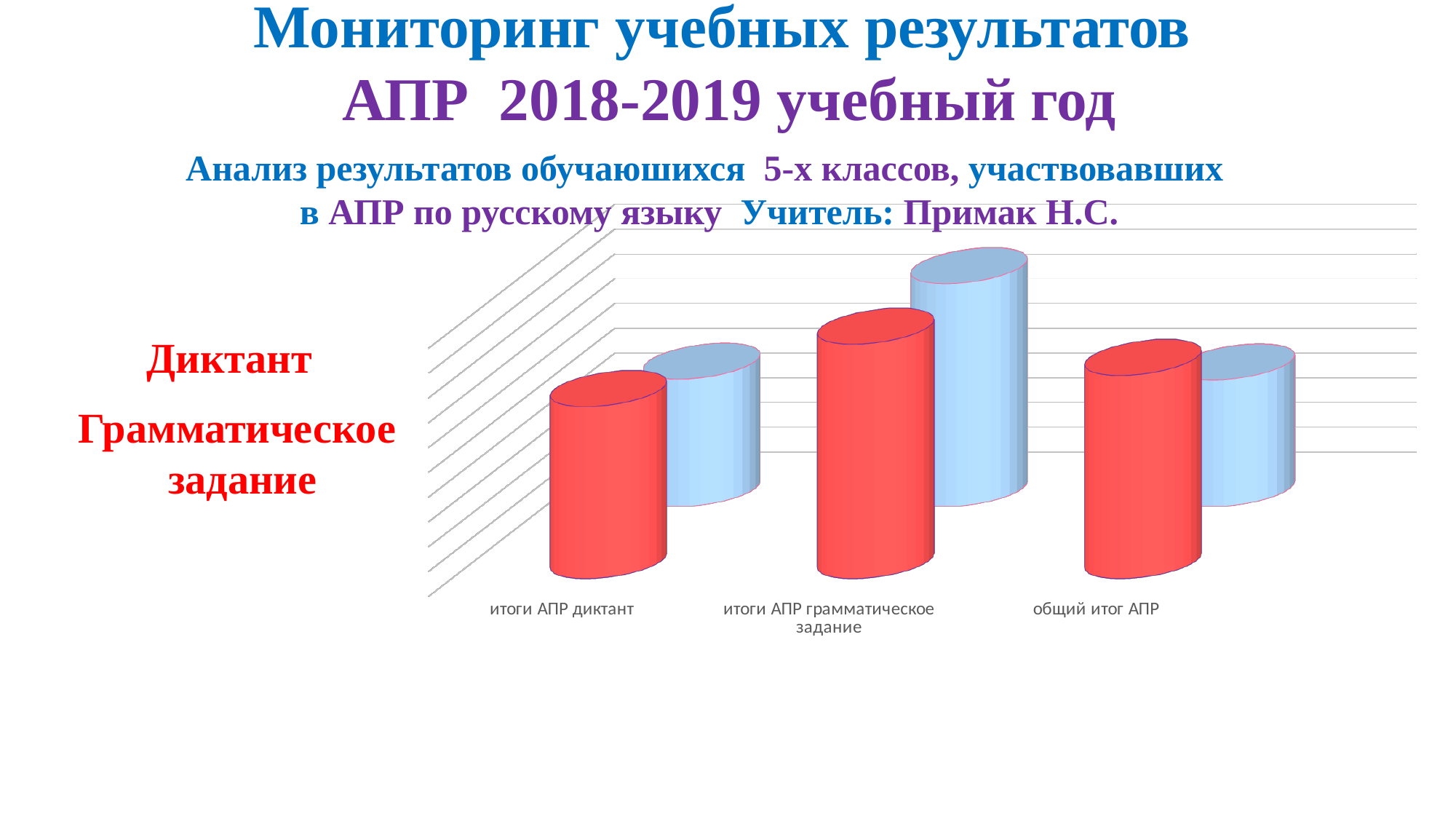
What kind of chart is shown on the slide? bar chart What is the label of the third category on the x axis? общий итог АПР For the red series, which category has the lowest bar? итоги АПР диктант For the light blue series, which category has the highest bar? итоги АПР грамматическое задание What is the label of the first category on the x axis? итоги АПР диктант For the red series, which category has the highest bar? итоги АПР грамматическое задание In the red series, which is larger: the bar for итоги АПР диктант or the bar for итоги АПР грамматическое задание? итоги АПР грамматическое задание In the light blue series, which is larger: the bar for итоги АПР диктант or the bar for итоги АПР грамматическое задание? итоги АПР грамматическое задание How many data series are plotted in the chart? 2 How many categories are shown on the x axis of the chart? 3 In the red series, which is larger: the bar for итоги АПР диктант or the bar for общий итог АПР? общий итог АПР